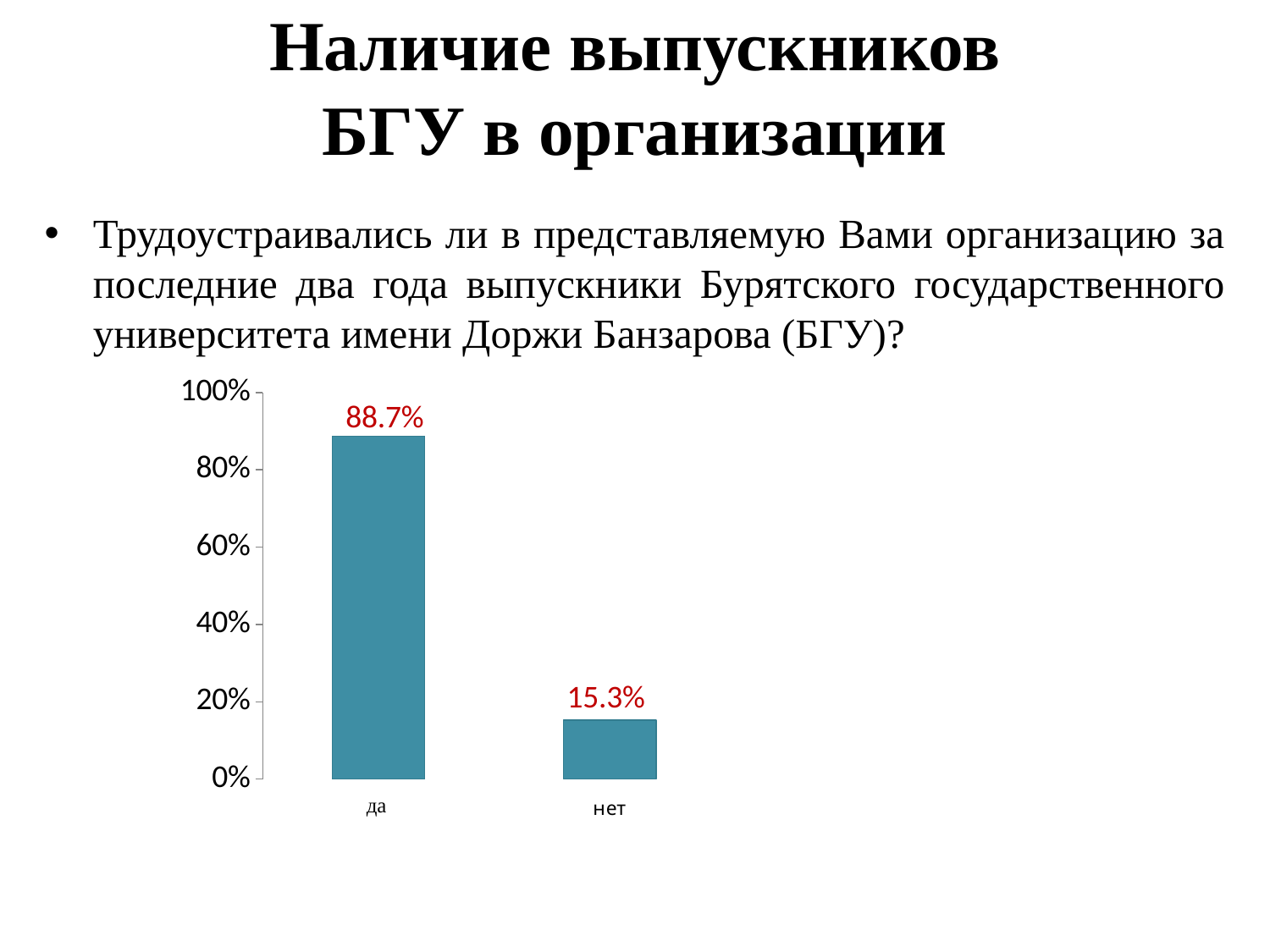
Which category has the highest value? да Is the value for "да" greater or less than 80%? greater How many categories are shown on the x axis? 2 Which is larger, the value for "да" or the value for "нет"? да What is the value for "да"? 88.7% What is the difference between the values for "да" and "нет"? 73.4% Is the value for "нет" greater or less than 20%? less What is the value for "нет"? 15.3% Which category has the lowest value? нет What colour are the bars in the chart? teal blue What is the highest tick value shown on the y axis? 100% What kind of chart is shown on the slide? bar chart